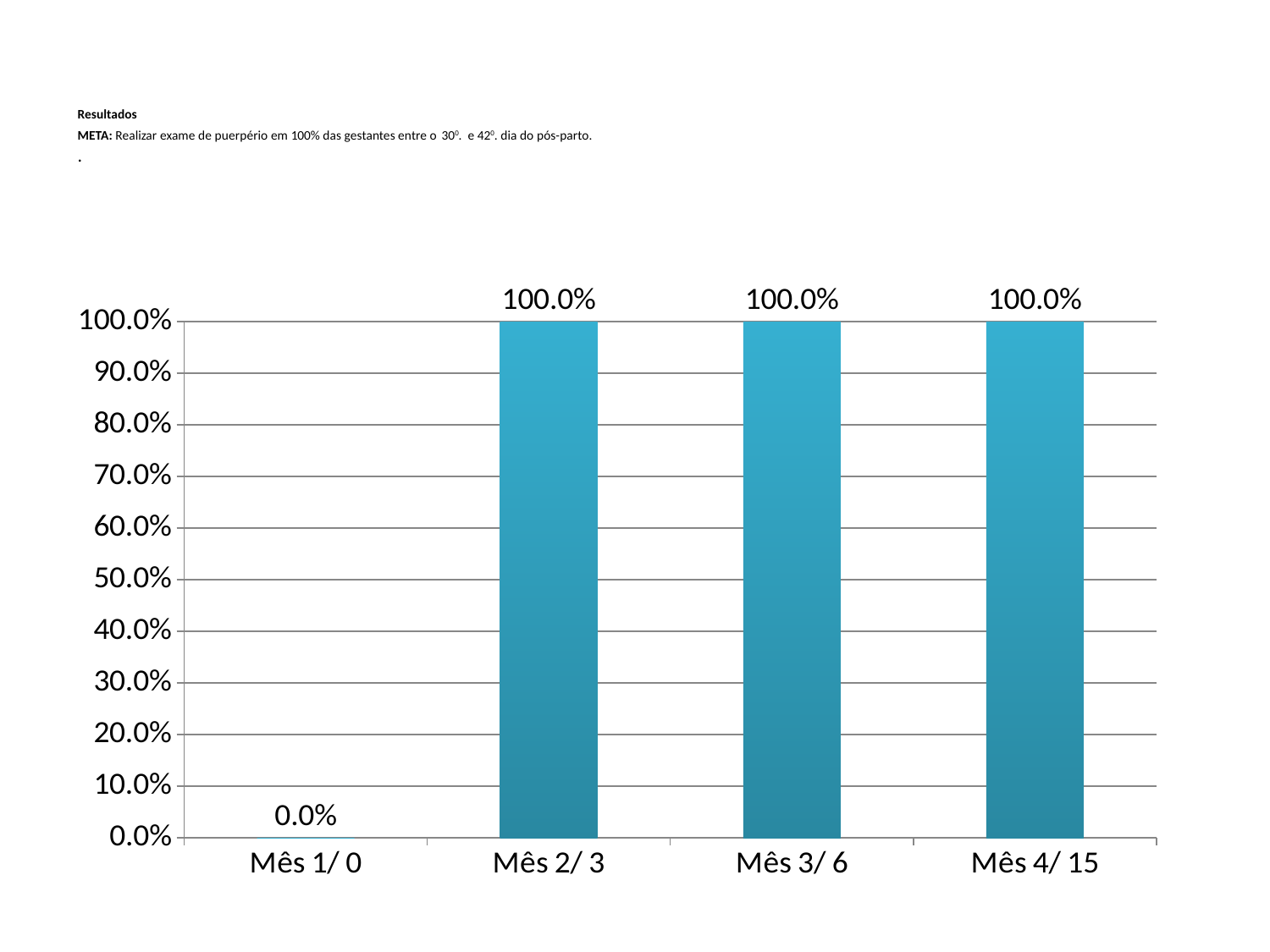
What is the difference between the values for Mês 3/ 6 and Mês 1/ 0? 100.0% What is the value for Mês 4/ 15? 100.0% What is the value for Mês 2/ 3? 100.0% What is the highest value shown on the y axis? 100.0% Which is larger, the value for Mês 1/ 0 or the value for Mês 2/ 3? Mês 2/ 3 Do the values rise or fall from Mês 1/ 0 to Mês 2/ 3? rise How many categories have a value of 100.0%? 3 How many categories are shown on the x axis? 4 What kind of chart is shown on the slide? bar chart What is the value for Mês 1/ 0? 0.0% Is the value for Mês 3/ 6 greater or less than 50.0%? greater Which category has the lowest value? Mês 1/ 0